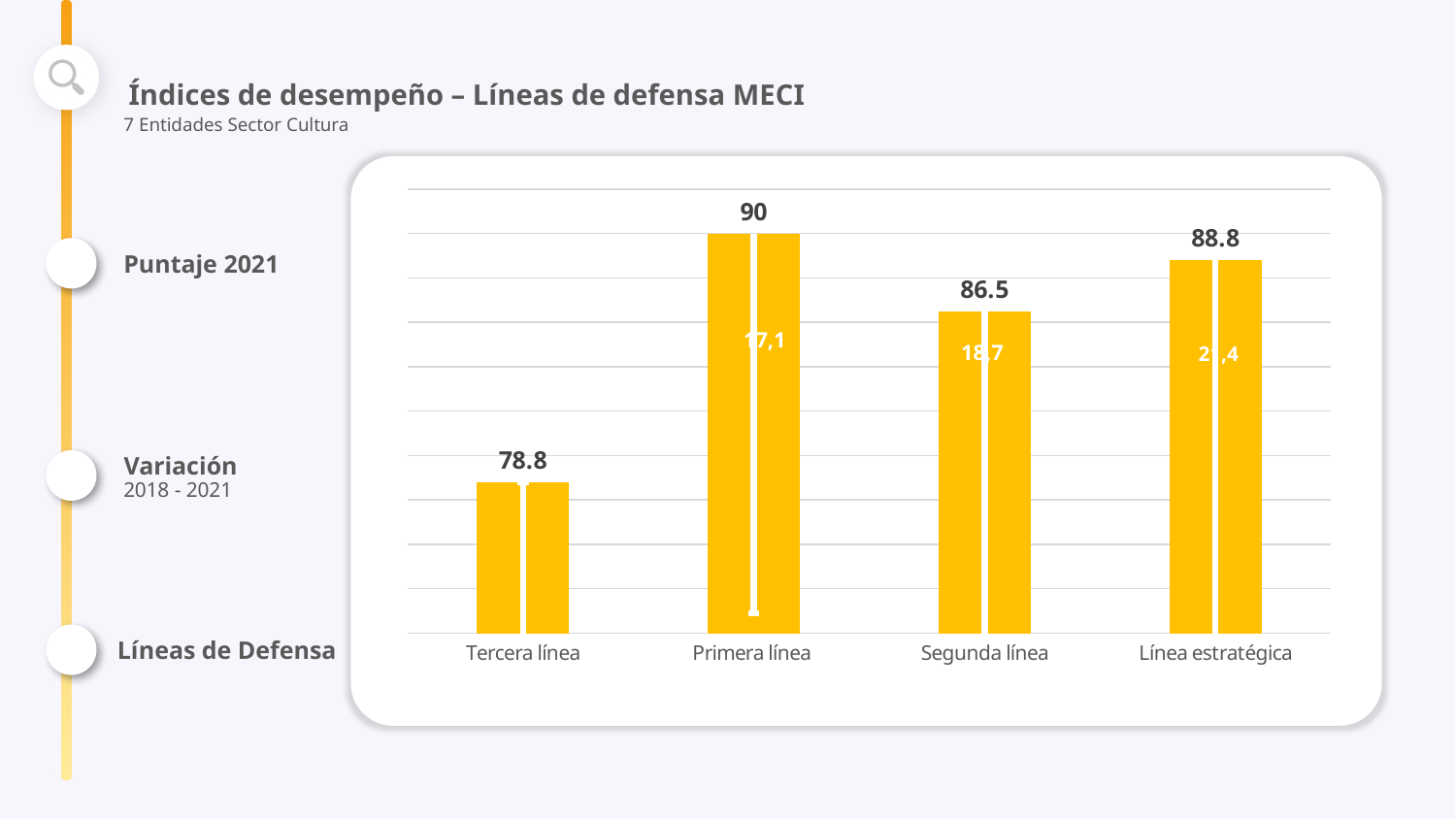
What is the Puntaje 2021 value for Segunda línea? 86.5 How many líneas de defensa are shown on the x axis of the chart? 4 Which línea de defensa has the highest Puntaje 2021? Primera línea What is the difference between the Puntaje 2021 of Línea estratégica and Segunda línea? 2.3 What is the Puntaje 2021 value for Primera línea? 90 What kind of chart is shown on the slide? Bar chart What is the difference between the Puntaje 2021 of Primera línea and Tercera línea? 11.2 What is the Puntaje 2021 value for Tercera línea? 78.8 Which has a higher Puntaje 2021, Segunda línea or Línea estratégica? Línea estratégica What is the Puntaje 2021 value for Línea estratégica? 88.8 Which línea de defensa has the lowest Puntaje 2021? Tercera línea What is the title of the slide containing the chart? Índices de desempeño – Líneas de defensa MECI